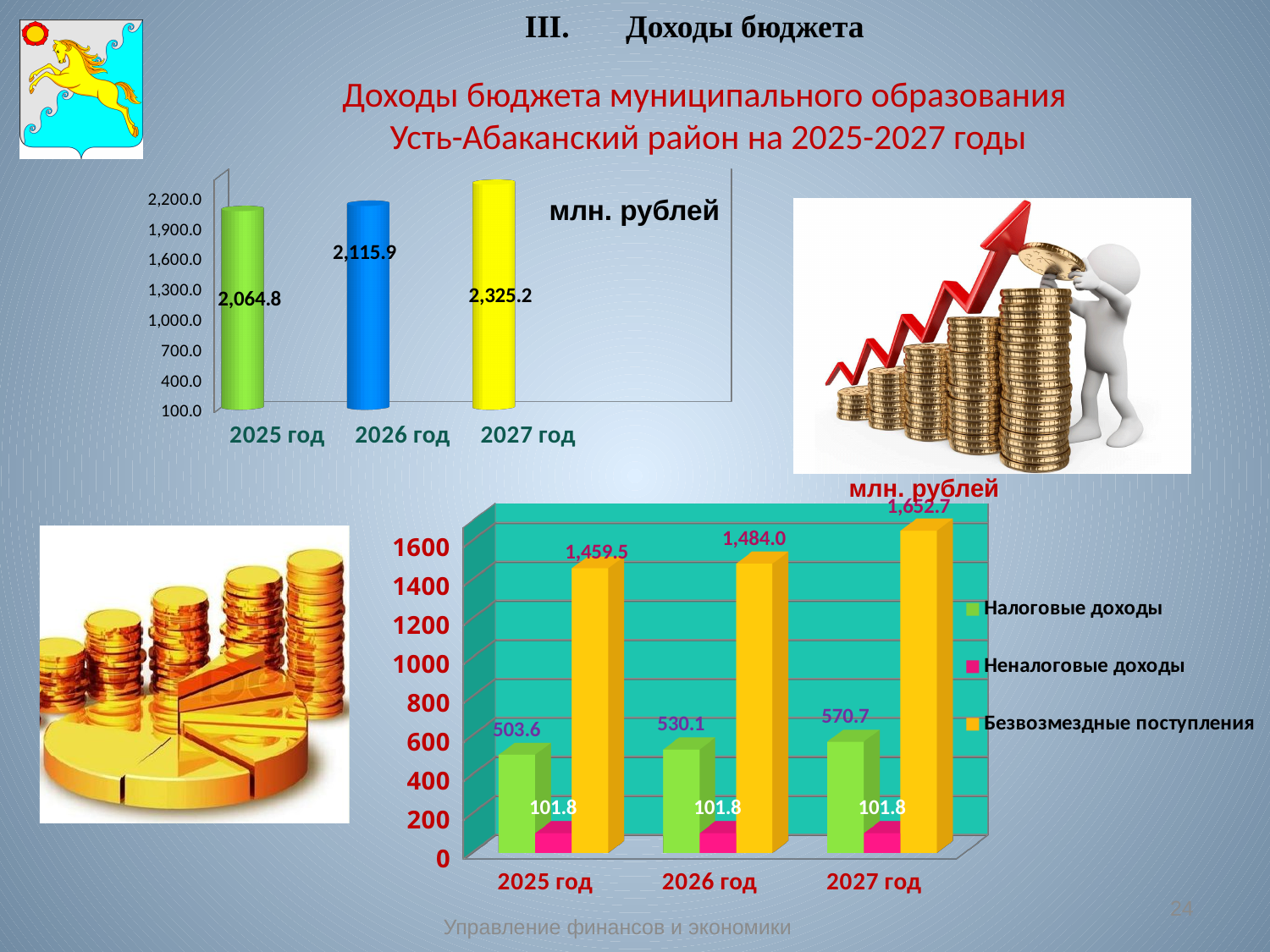
In the bottom chart, what is the value of Неналоговые доходы for 2025 год? 101.8 What kind of chart is the bottom chart? bar chart In the bottom chart, which is larger for 2025 год: Налоговые доходы or Безвозмездные поступления? Безвозмездные поступления In the top-left chart, do the values rise or fall from 2025 год to 2027 год? rise In the top-left chart, what is the difference between the values for 2027 год and 2025 год? 260.4 In the top-left chart, which year has the highest value? 2027 год In the top-left chart, how many bars are plotted? 3 In the bottom chart, what is the value of Налоговые доходы for 2027 год? 570.7 In the bottom chart, what is the value of Безвозмездные поступления for 2026 год? 1,484.0 In the top-left chart, what is the value for 2025 год? 2,064.8 In the top-left chart, what is the value for 2027 год? 2,325.2 In the bottom chart, how many series does the legend list? 3